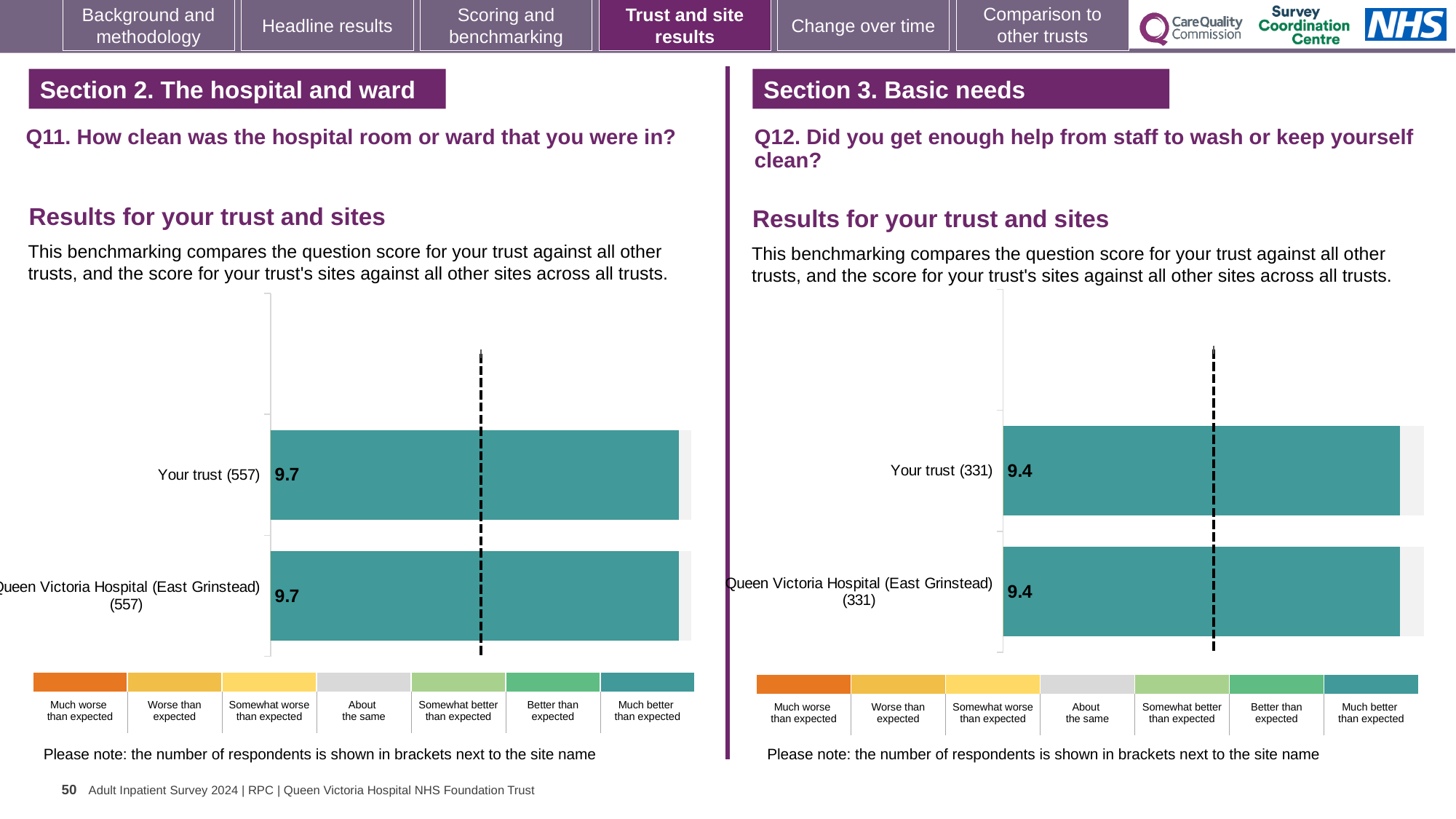
In the Q12 chart on the right, what is the score for Your trust (331)? 9.4 What type of chart is used for the Q11 results on the left? Bar chart In the Q11 chart on the left, what is the difference between the score for Your trust and the score for Queen Victoria Hospital (East Grinstead)? 0 Is the Your trust score in the Q11 chart on the left larger or smaller than the Your trust score in the Q12 chart on the right? Larger In the Q12 chart on the right, what is the difference between the score for Your trust and the score for Queen Victoria Hospital (East Grinstead)? 0 In the Q12 chart on the right, what is the score for Queen Victoria Hospital (East Grinstead) (331)? 9.4 How many bars are plotted in the Q11 chart on the left? 2 How many respondents are shown in brackets for Your trust in the Q12 chart on the right? 331 In the Q11 chart on the left, what is the score for Your trust (557)? 9.7 How many bars are plotted in the Q12 chart on the right? 2 In the Q11 chart on the left, what is the score for Queen Victoria Hospital (East Grinstead) (557)? 9.7 According to the colour key below the Q11 chart on the left, which benchmark category does the teal colour of the bars represent? Much better than expected